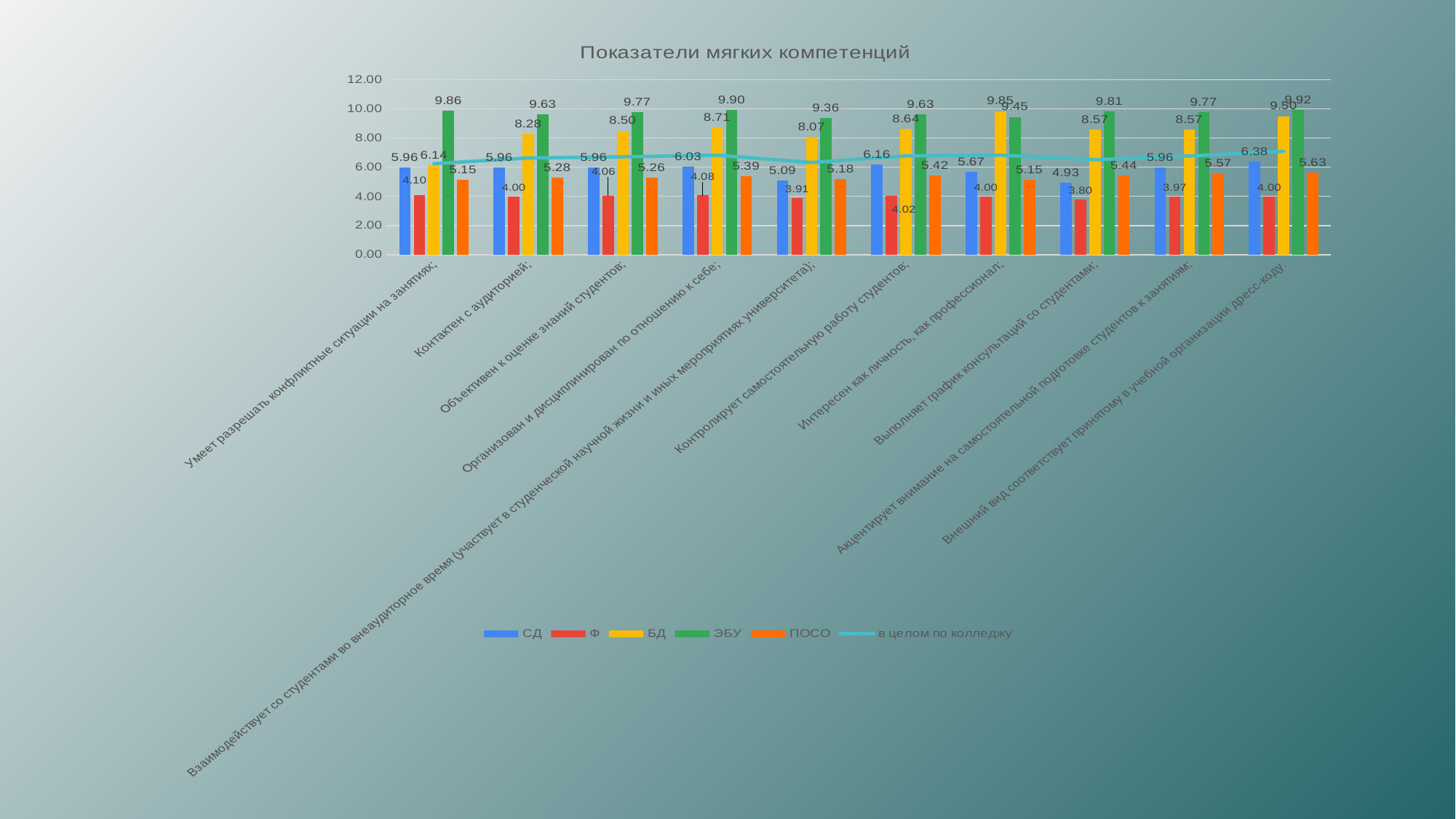
What is the value of Ф for the category "Выполняет график консультаций со студентами"? 3.80 What is the value of ЭБУ for the category "Контактен с аудиторией"? 9.63 What is the difference between the ЭБУ and Ф values for the category "Организован и дисциплинирован по отношению к себе"? 5.82 What is the value of БД for the category "Умеет разрешать конфликтные ситуации на занятиях"? 6.14 What is the title of the chart? Показатели мягких компетенций For which category is the СД value the lowest? Выполняет график консультаций со студентами For which category is the ЭБУ value the highest? Внешний вид соответствует принятому в учебной организации дресс-коду How many categories are shown on the x axis of the chart? 10 How many series does the legend list? 6 What is the value of ПОСО for the category "Внешний вид соответствует принятому в учебной организации дресс-коду"? 5.63 For the category "Интересен как личность, как профессионал", which series has the larger value, БД or ЭБУ? БД Is the value of the "в целом по колледжу" line for the category "Умеет разрешать конфликтные ситуации на занятиях" greater or less than 8.00? less